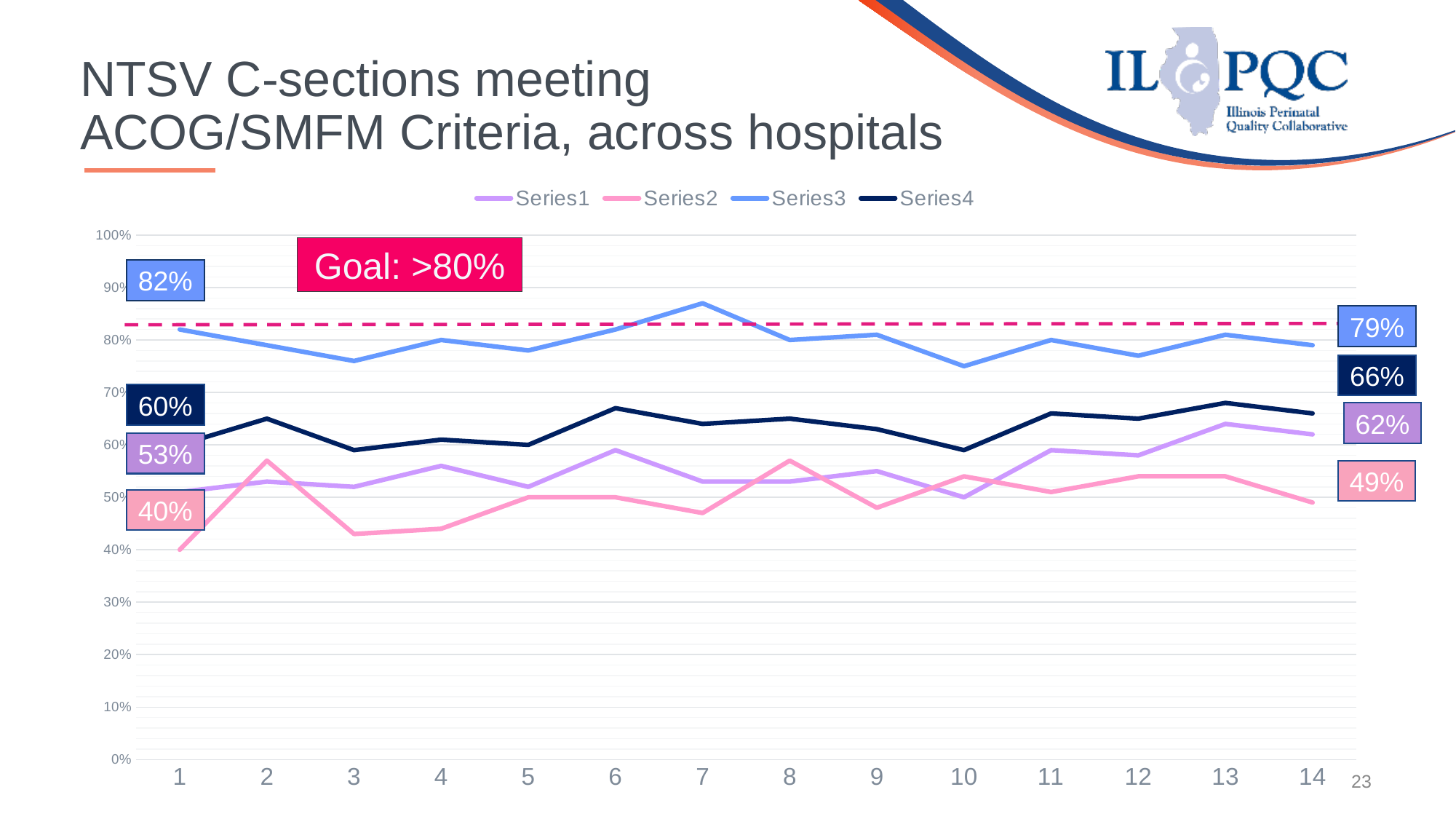
What is the value of Series3 at point 14? 79% Is the value of Series3 at point 7 greater or less than 80%? greater What is the difference between the Series1 value at point 14 and at point 1? 9% Which series has the lowest value at point 14? Series2 What is the value of Series3 at point 1? 82% What goal is stated in the box on the chart? Goal: >80% Which series has the highest value at point 1? Series3 How many series does the legend list? 4 How many points are plotted along the x axis for each series? 14 What is the value of Series4 at point 14? 66% What is the value of Series2 at point 1? 40% What type of chart is shown on the slide? line chart